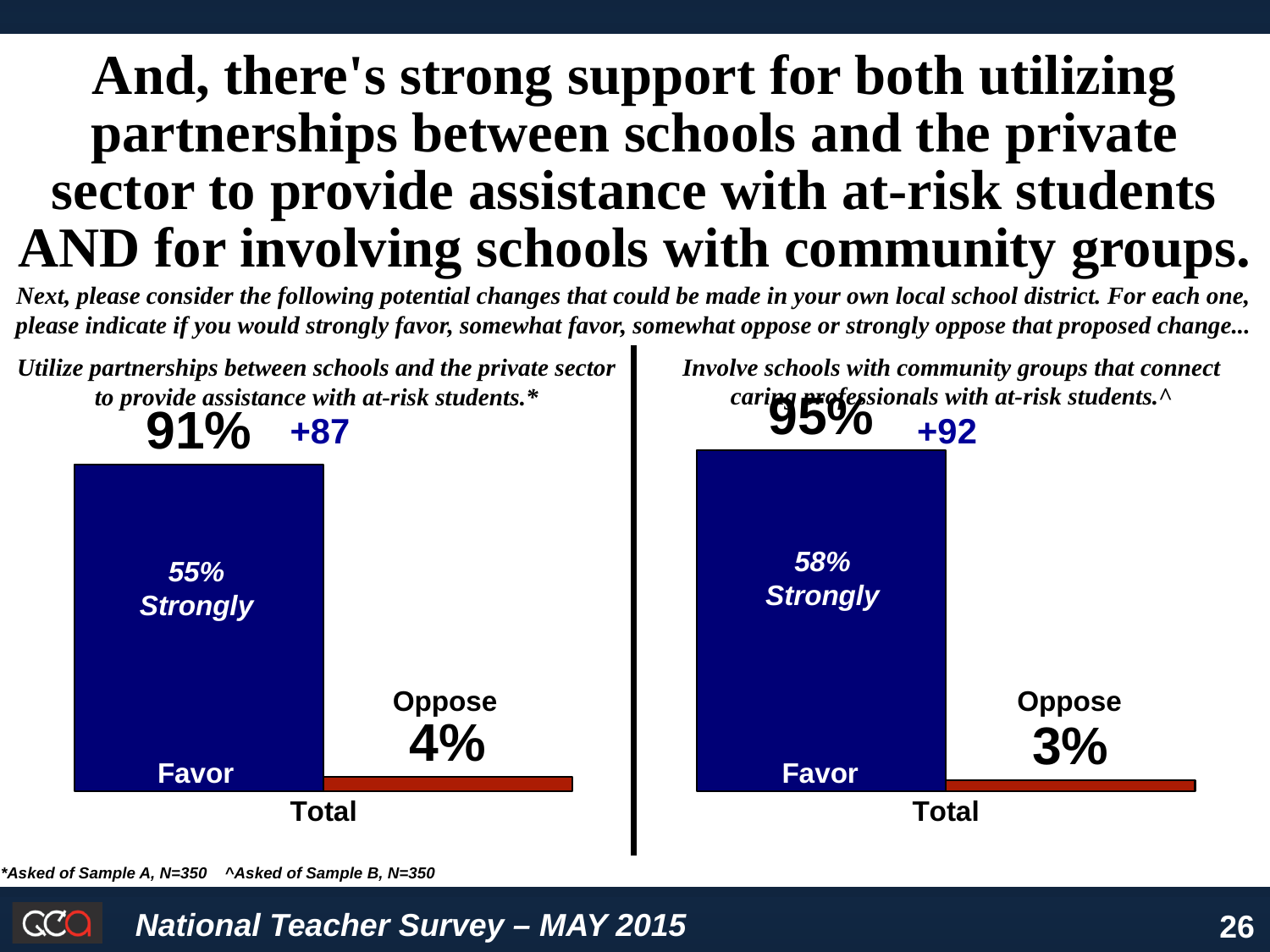
On the left chart (private sector partnerships), what percentage strongly favor the proposal? 55% On the left chart (private sector partnerships), what percentage oppose the proposal? 4% On the left chart (private sector partnerships), what percentage of teachers favor the proposal? 91% What colour is the Oppose bar on the right chart (community groups)? Red On the right chart (community groups), what percentage strongly favor the proposal? 58% What type of chart is used on the left side of the slide? Bar chart Which chart shows the higher Favor percentage, the left (private sector partnerships) or the right (community groups)? Right (community groups) On the right chart (community groups), what is the net favor figure shown next to the Favor bar? +92 On the right chart (community groups), what percentage of teachers favor the proposal? 95% On the right chart (community groups), what percentage oppose the proposal? 3% On the left chart (private sector partnerships), what is the difference between the Favor and Oppose percentages? 87 On the left chart (private sector partnerships), which is larger, Favor or Oppose? Favor